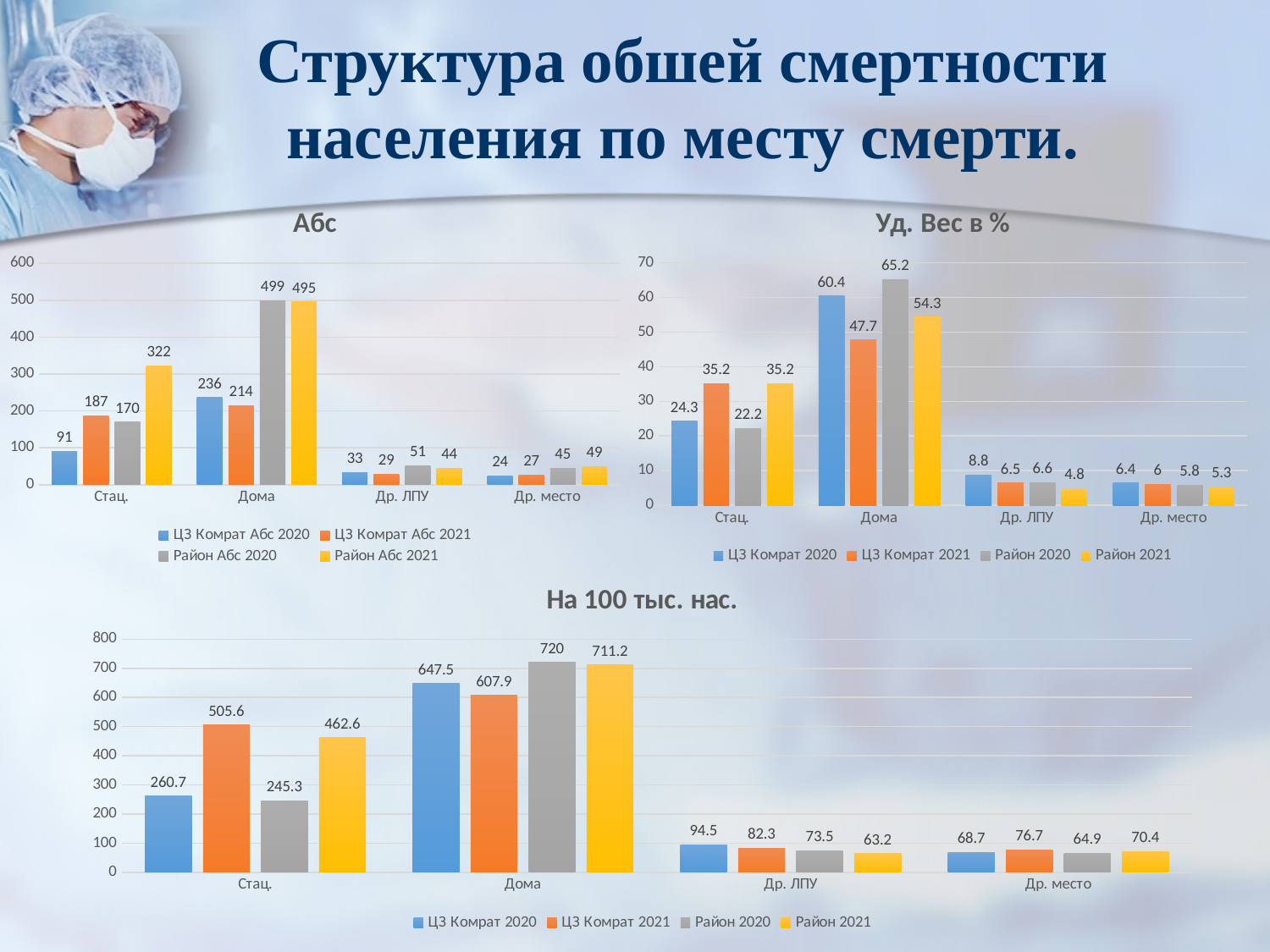
In the 'Абс' chart, what is the difference between Район Абс 2020 and Район Абс 2021 in the Дома category? 4 In the 'Уд. Вес в %' chart, which is larger in the Стац. category: ЦЗ Комрат 2020 or ЦЗ Комрат 2021? ЦЗ Комрат 2021 What type of chart is the 'На 100 тыс. нас.' chart? Bar chart In the 'Абс' chart, what is the value for Район Абс 2021 in the Стац. category? 322 In the 'Уд. Вес в %' chart, what is the value for Район 2020 in the Дома category? 65.2 In the 'На 100 тыс. нас.' chart, what is the value for ЦЗ Комрат 2021 in the Стац. category? 505.6 In the 'Абс' chart, what is the value for ЦЗ Комрат Абс 2020 in the Дома category? 236 How many categories are shown on the x axis of the 'На 100 тыс. нас.' chart? 4 How many series does the legend of the 'Уд. Вес в %' chart list? 4 In the 'Уд. Вес в %' chart, which category has the lowest value for Район 2021? Др. ЛПУ In the 'Абс' chart, which category has the highest value for Район Абс 2020? Дома In the 'На 100 тыс. нас.' chart, what is the difference between Район 2020 and Район 2021 in the Дома category? 8.8